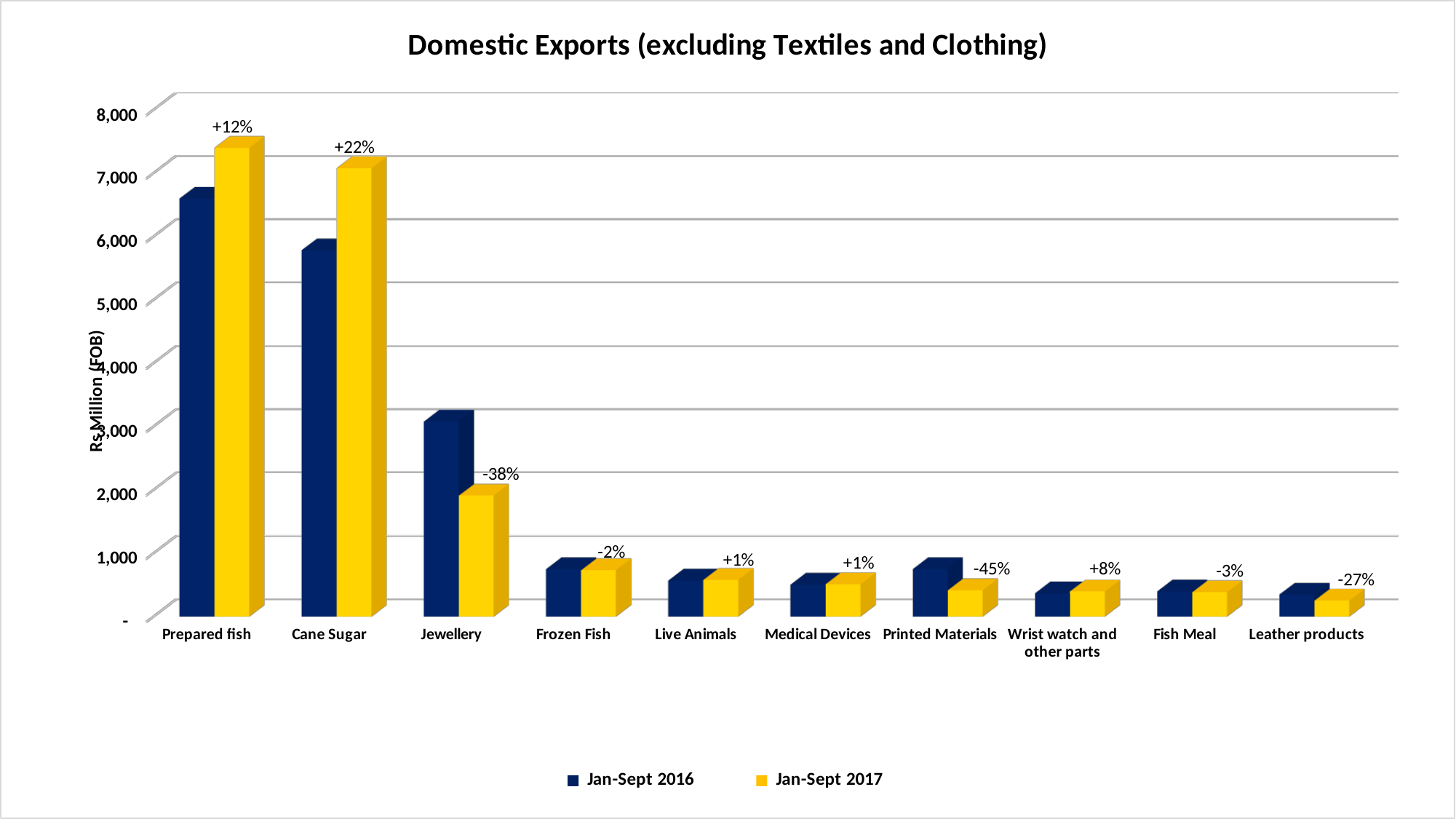
What percentage change is labelled above the Cane Sugar bars? +22% How many product categories are shown on the x axis? 10 Which category shows the largest percentage decrease according to the data labels? Printed Materials Is the Jan-Sept 2017 value for Jewellery greater or less than 3,000? less Which category has the highest Jan-Sept 2017 bar? Prepared fish What percentage change is labelled for Printed Materials? -45% What is the title of the chart? Domestic Exports (excluding Textiles and Clothing) Is the Jan-Sept 2016 value for Prepared fish greater or less than 6,000? greater What percentage change is labelled for Jewellery? -38% What kind of chart is shown on the slide? bar chart Which is larger for Jan-Sept 2016: Cane Sugar or Jewellery? Cane Sugar How many series does the legend list? 2